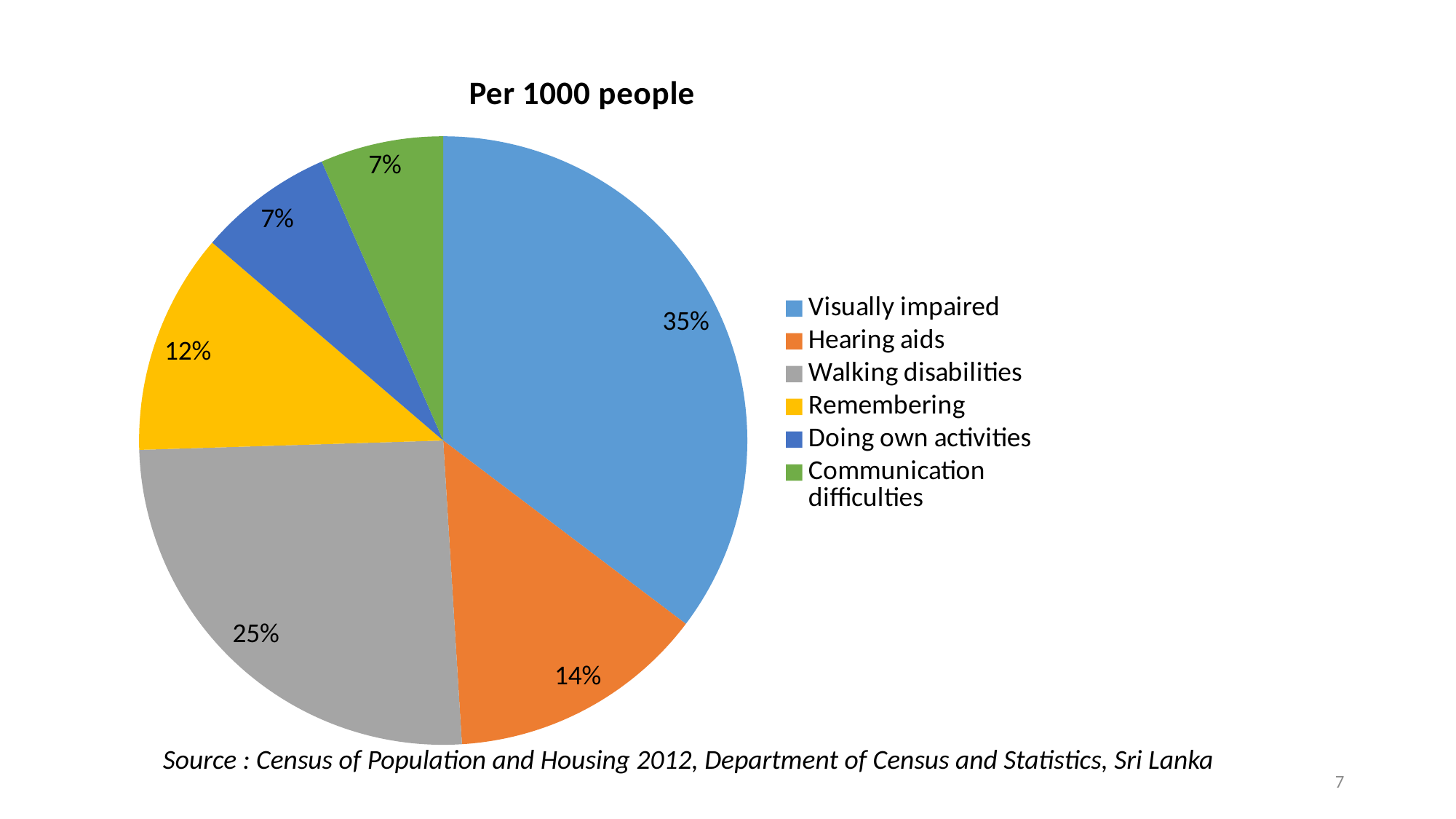
What share of the pie does Remembering represent? 12% Which category has the largest slice of the pie? Visually impaired Which is larger, the slice for Hearing aids or the slice for Remembering? Hearing aids What share of the pie does Visually impaired represent? 35% What is the title of the chart? Per 1000 people Which colour represents Communication difficulties in the pie chart? green How many categories does the legend list? 6 What share of the pie does Hearing aids represent? 14% What type of chart is shown on the slide? pie chart What is the difference in percentage points between Walking disabilities and Hearing aids? 11% What is the difference in percentage points between Visually impaired and Walking disabilities? 10%